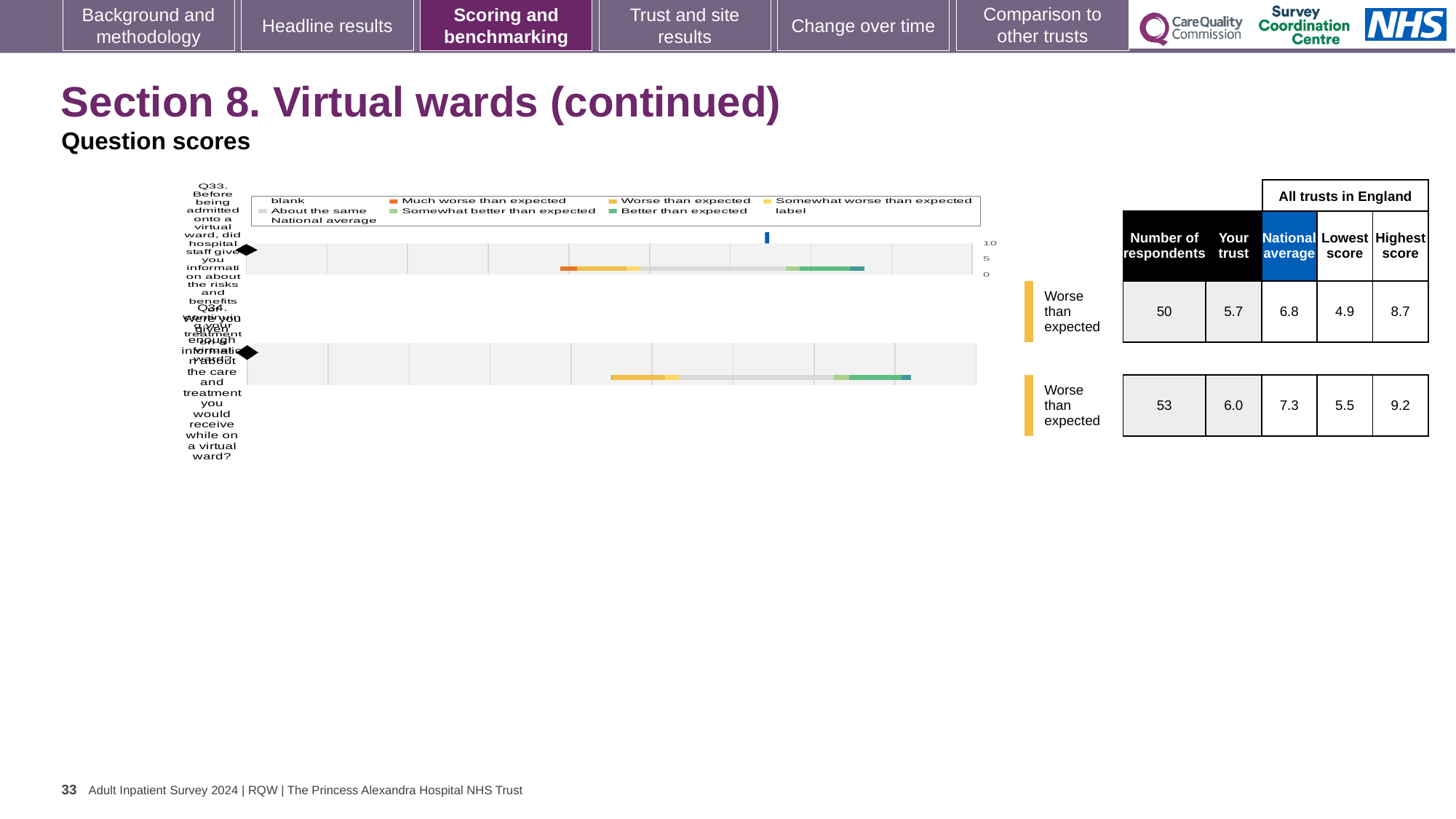
What kind of chart is used to show the question scores for Q33 and Q34? bar chart What is the number of respondents for Q33 in the table next to the chart? 50 How many questions (bars) are plotted in the chart? 2 For Q33, which is larger: the 'Your trust' score or the national average? National average What is the lowest score across all trusts in England for Q33? 4.9 Which question has more respondents, Q33 or Q34? Q34 What is the highest score across all trusts in England for Q34? 9.2 Which legend entry is shown in grey in the chart legend? About the same What is the national average score for Q34? 7.3 What is the 'Your trust' score for Q33? 5.7 What is the difference between the highest score and the lowest score for Q34? 3.7 What benchmark rating is shown for Q34? Worse than expected